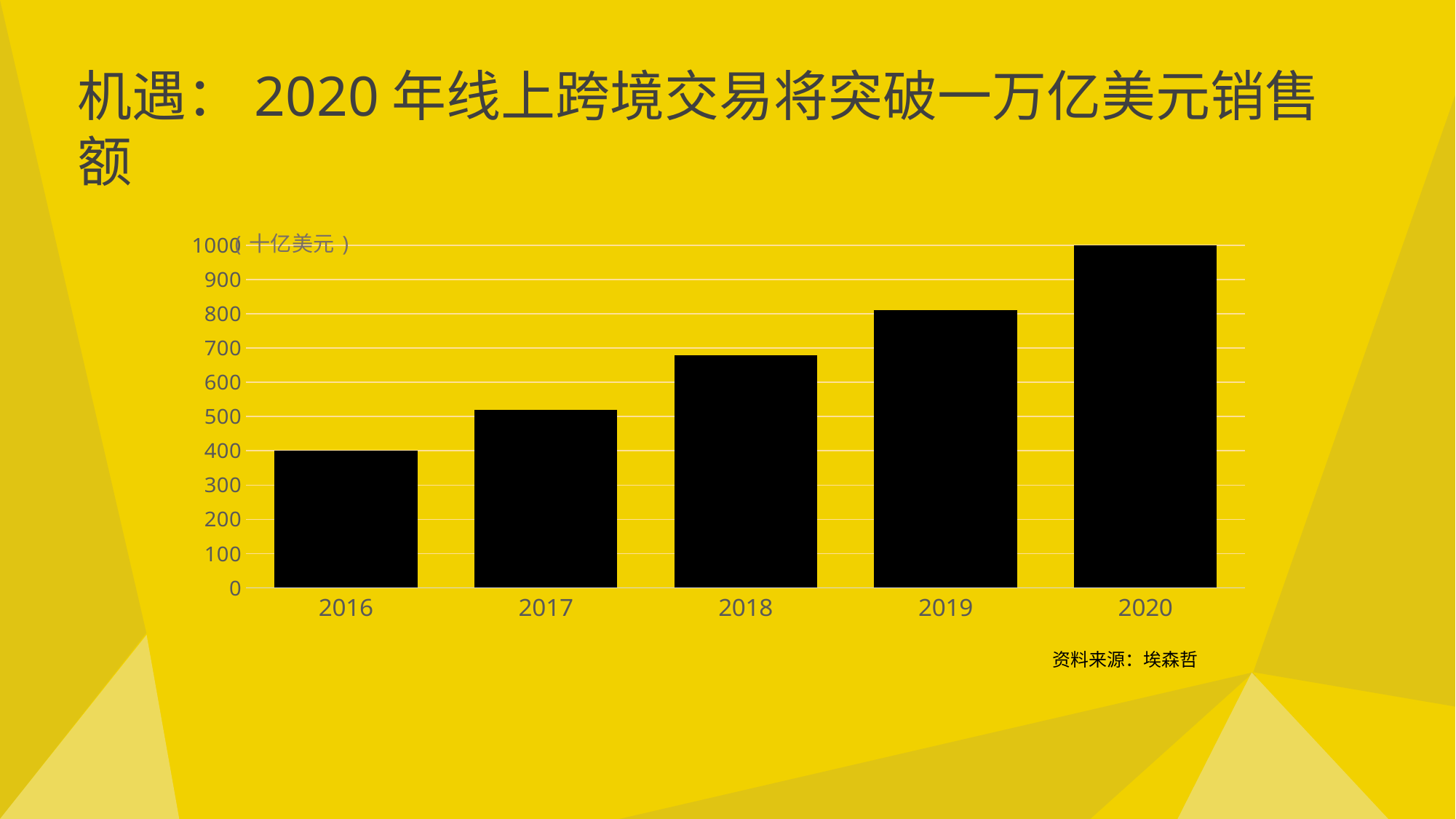
Is the value for 2017 greater or less than 600? less Is the value for 2019 greater or less than 900? less What is the value for 2020 in the chart? 1000 Is the value for 2018 greater or less than 600? greater Which year has the lowest bar in the chart? 2016 Which is larger, the value for 2018 or the value for 2019? 2019 What unit is shown next to the top of the y axis? 十亿美元 Do the values rise or fall from 2016 to 2020? rise How many years are shown on the x axis of the chart? 5 What kind of chart is shown on the slide? bar chart What is the value for 2016 in the chart? 400 Which year has the highest bar in the chart? 2020